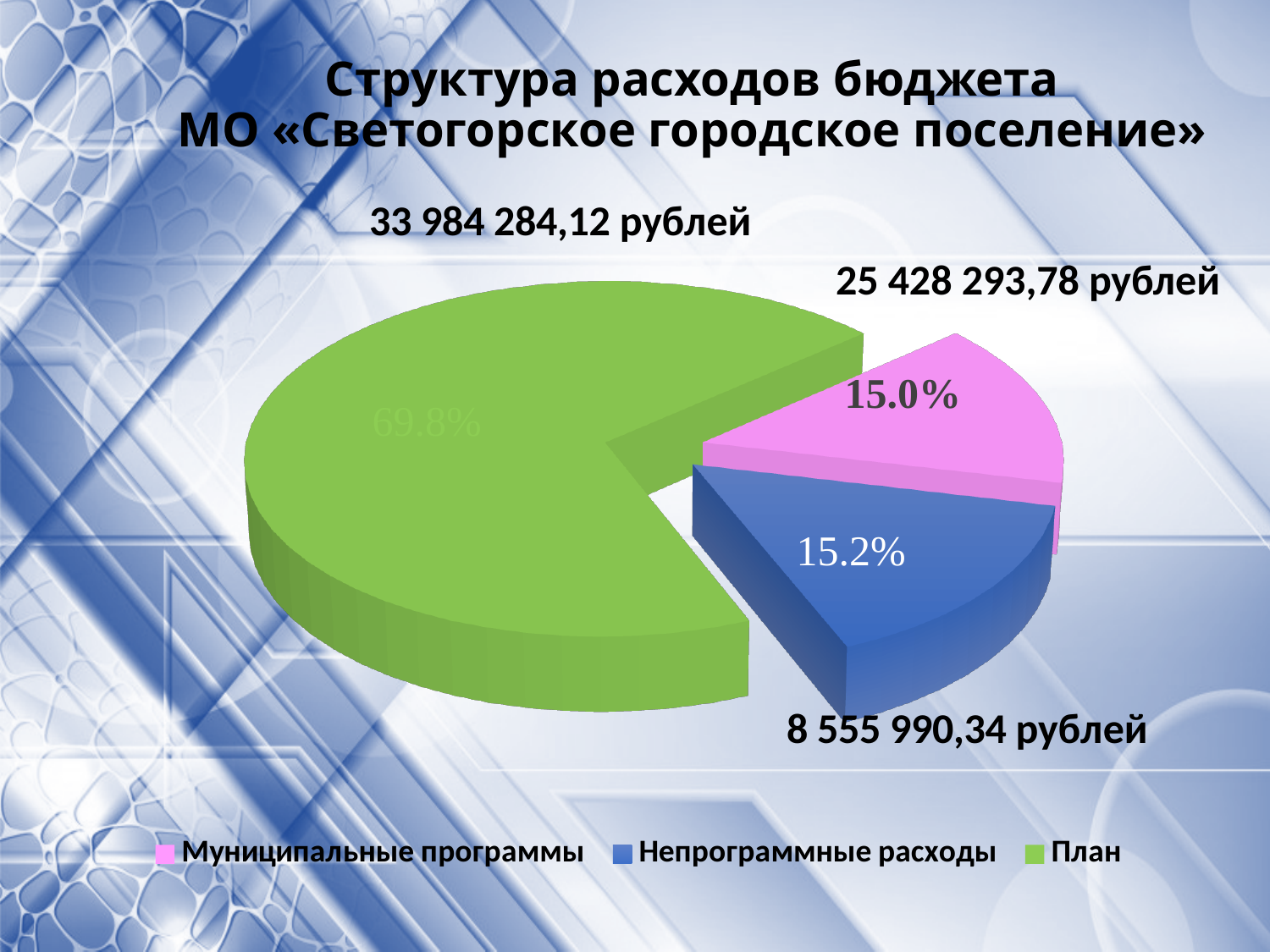
What percentage share is shown for the slice "Муниципальные программы"? 15.0% By how many percentage points does the "Непрограммные расходы" slice exceed the "Муниципальные программы" slice? 0.2 What percentage share is shown for the slice "План"? 69.8% How many categories does the legend of the pie chart list? 3 Which slice of the pie chart is the largest? План What percentage share is shown for the slice "Непрограммные расходы"? 15.2% What colour is the "План" slice in the pie chart? green Is the share of the "План" slice greater or less than 50%? greater Which slice of the pie chart is the smallest? Муниципальные программы What colour is the "Муниципальные программы" slice in the pie chart? pink Which slice is larger, "Непрограммные расходы" or "Муниципальные программы"? Непрограммные расходы What kind of chart is shown on the slide? pie chart